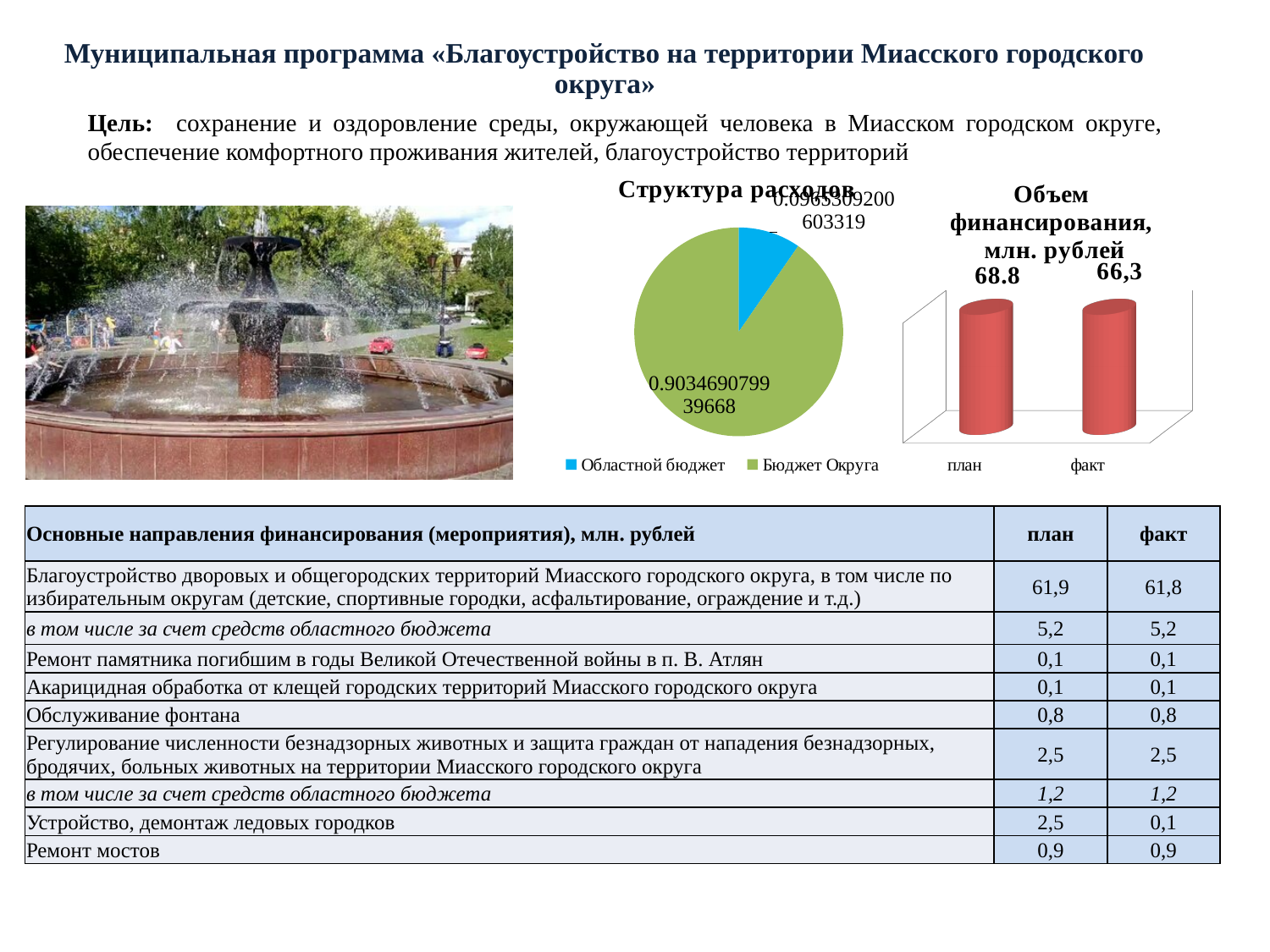
In the chart titled «Объем финансирования, млн. рублей», by how much does план exceed факт? 2.5 In the pie chart titled «Структура расходов», what colour is the «Областной бюджет» slice? blue In the chart titled «Объем финансирования, млн. рублей», which category has the higher value, план or факт? план What kind of chart is the one titled «Структура расходов»? pie chart What kind of chart is the one titled «Объем финансирования, млн. рублей»? bar chart In the chart titled «Объем финансирования, млн. рублей», which category has the lowest value? факт How many entries does the legend of the pie chart «Структура расходов» list? 2 In the chart titled «Объем финансирования, млн. рублей», how many bars are plotted? 2 In the pie chart titled «Структура расходов», what value is labelled on the «Бюджет Округа» slice? 0.903469079939668 In the chart titled «Объем финансирования, млн. рублей», what is the value for план? 68.8 In the pie chart titled «Структура расходов», which slice is the largest? Бюджет Округа In the chart titled «Объем финансирования, млн. рублей», what is the value for факт? 66,3